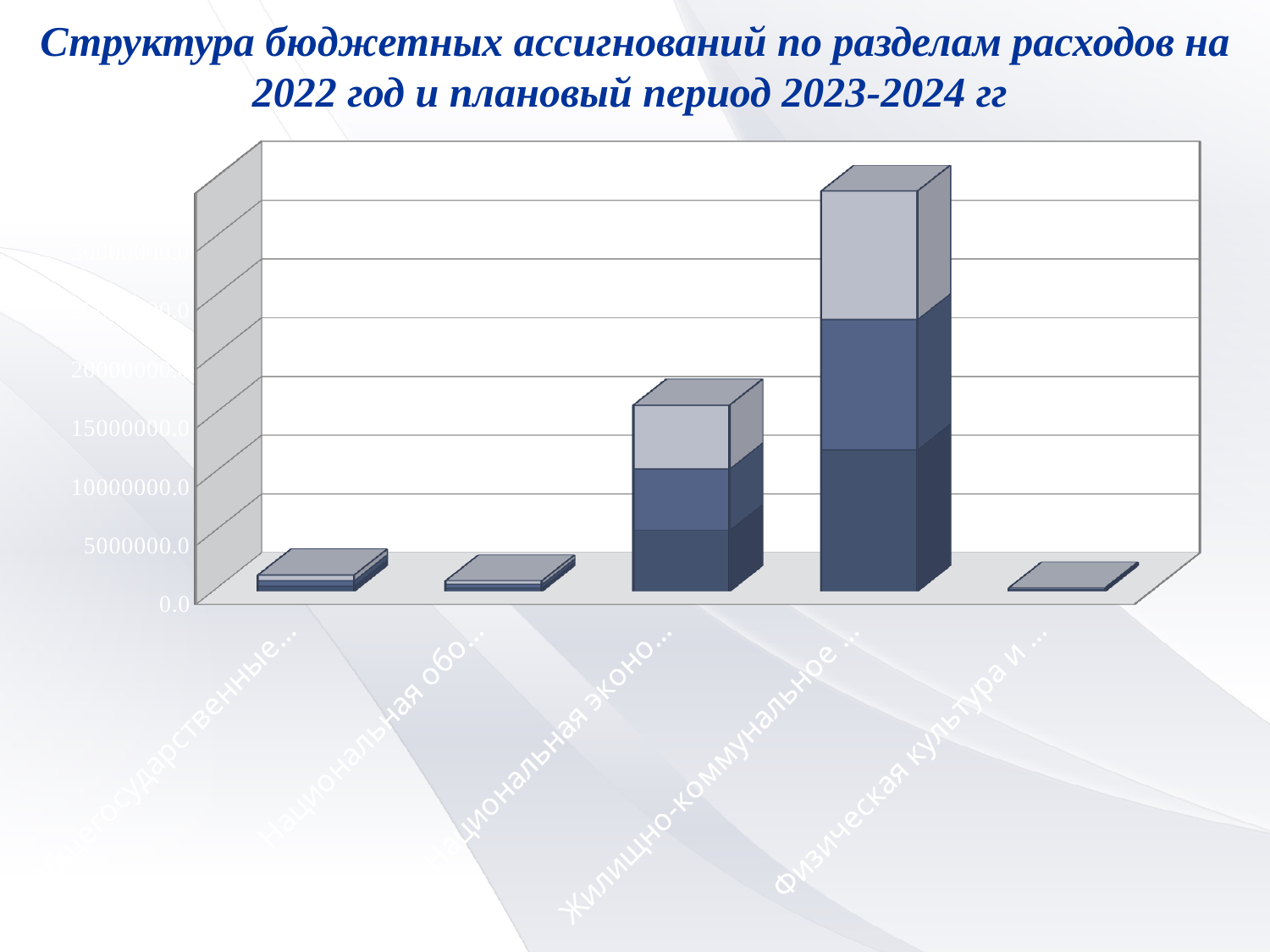
Are the bars in the chart stacked or side by side? stacked What is the title of the slide containing the chart? Структура бюджетных ассигнований по разделам расходов на 2022 год и плановый период 2023-2024 гг Is the total value for Жилищно-коммунальное ... greater or less than 25000000.0? greater Is the total value for Национальная эконо... greater or less than 10000000.0? greater What kind of chart is shown on the slide? bar chart How many stacked segments make up the bar for Жилищно-коммунальное ...? 3 Which is larger, the bar for Жилищно-коммунальное ... or the bar for Национальная эконо...? Жилищно-коммунальное ... Which category has the highest total value? Жилищно-коммунальное ... How many categories (bars) are shown on the chart? 5 Is the value for Физическая культура и ... greater or less than 5000000.0? less Which is larger, the bar for Национальная эконо... or the bar for Общегосударственные...? Национальная эконо...